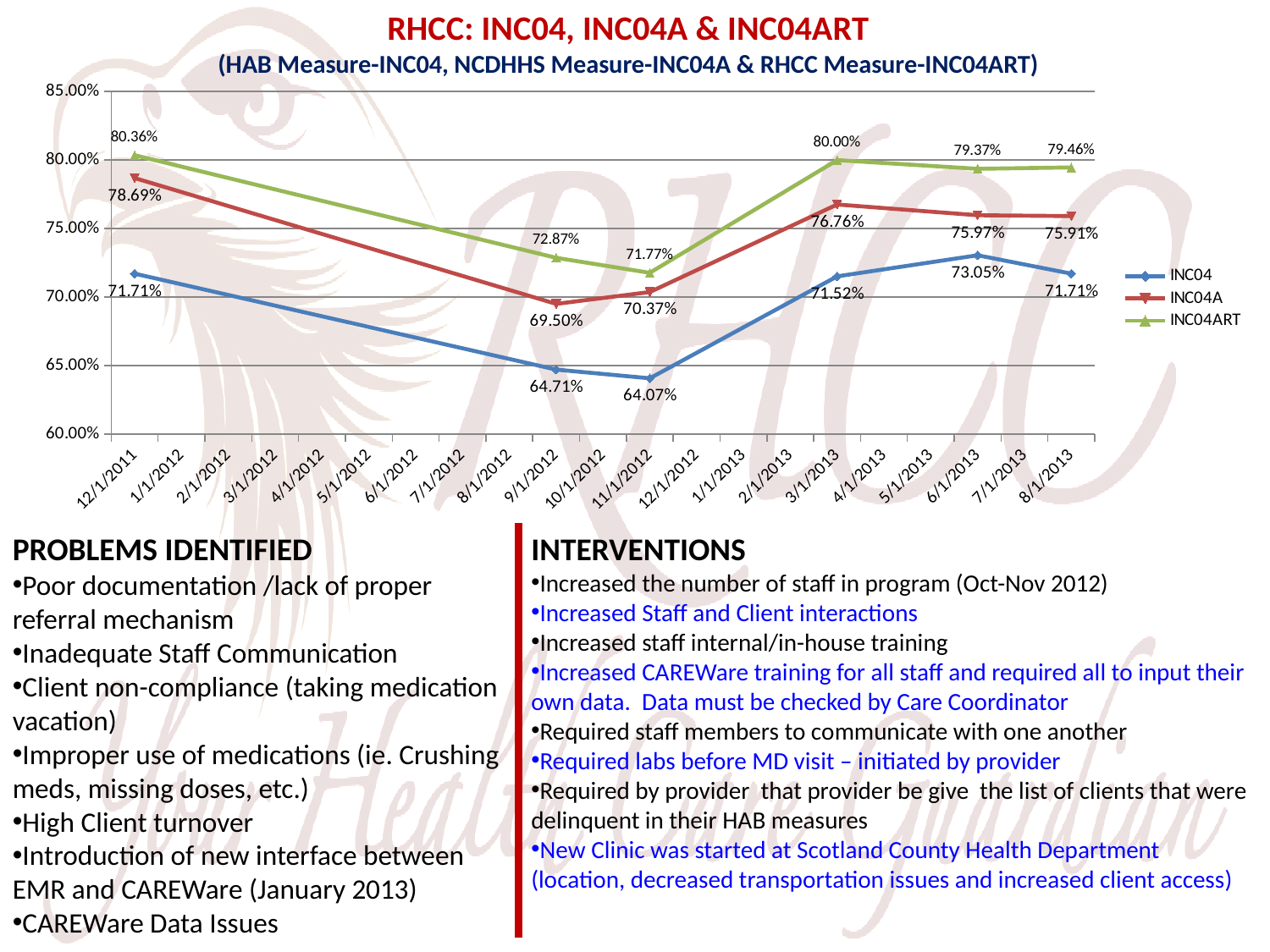
Which series is drawn in green? INC04ART What is the INC04A value at 6/1/2013? 75.97% Does the INC04A series rise or fall between 12/1/2011 and 9/1/2012? Fall How many labelled data points does the INC04 series have? 6 What is the INC04 value at 11/1/2012? 64.07% Which series has the higher value at 9/1/2012, INC04A or INC04ART? INC04ART What is the difference between the INC04ART and INC04 values at 3/1/2013? 8.48% How many series does the legend list? 3 What kind of chart is shown on the slide? Line chart At which date does the INC04 series reach its lowest value? 11/1/2012 What is the INC04ART value at 12/1/2011? 80.36% At which date does the INC04ART series reach its highest value? 12/1/2011